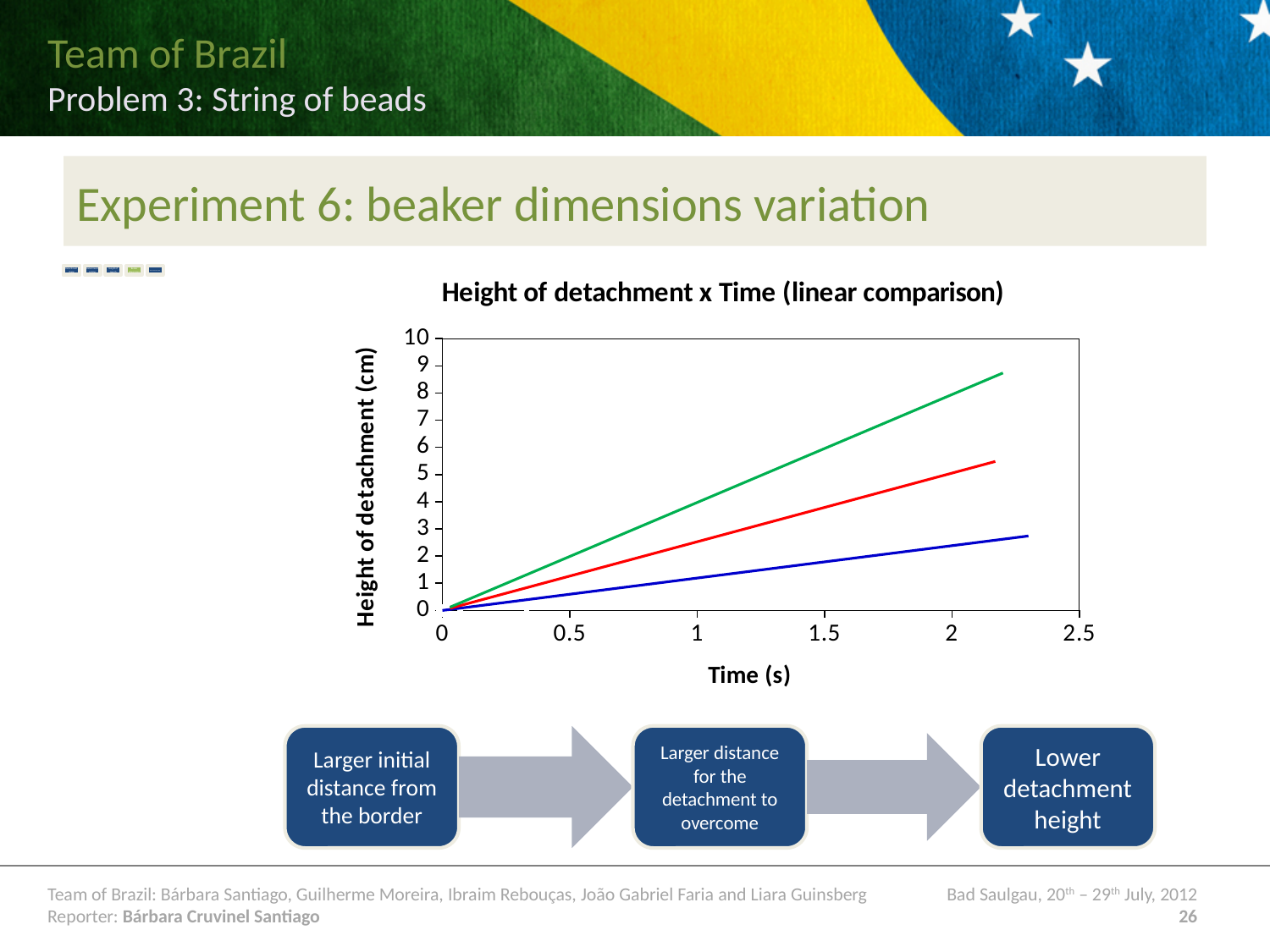
At a time of 1.5 s, which line has the larger value, the red line or the blue line? Red What is the title of the chart? Height of detachment x Time (linear comparison) At a time of 2 s, is the value of the blue line greater or less than 5 cm? less At a time of 2 s, is the value of the green line greater or less than 5 cm? greater At a time of 1 s, is the value of the red line greater or less than 4 cm? less How many lines are plotted on the chart? 3 At a time of 2 s, which line has the larger value, the green line or the blue line? Green Which coloured line has the lowest height of detachment? Blue What is the label of the vertical axis of the chart? Height of detachment (cm) Which coloured line reaches the highest height of detachment? Green Do the plotted lines rise or fall as time increases? Rise What kind of chart is shown on the slide? Line chart